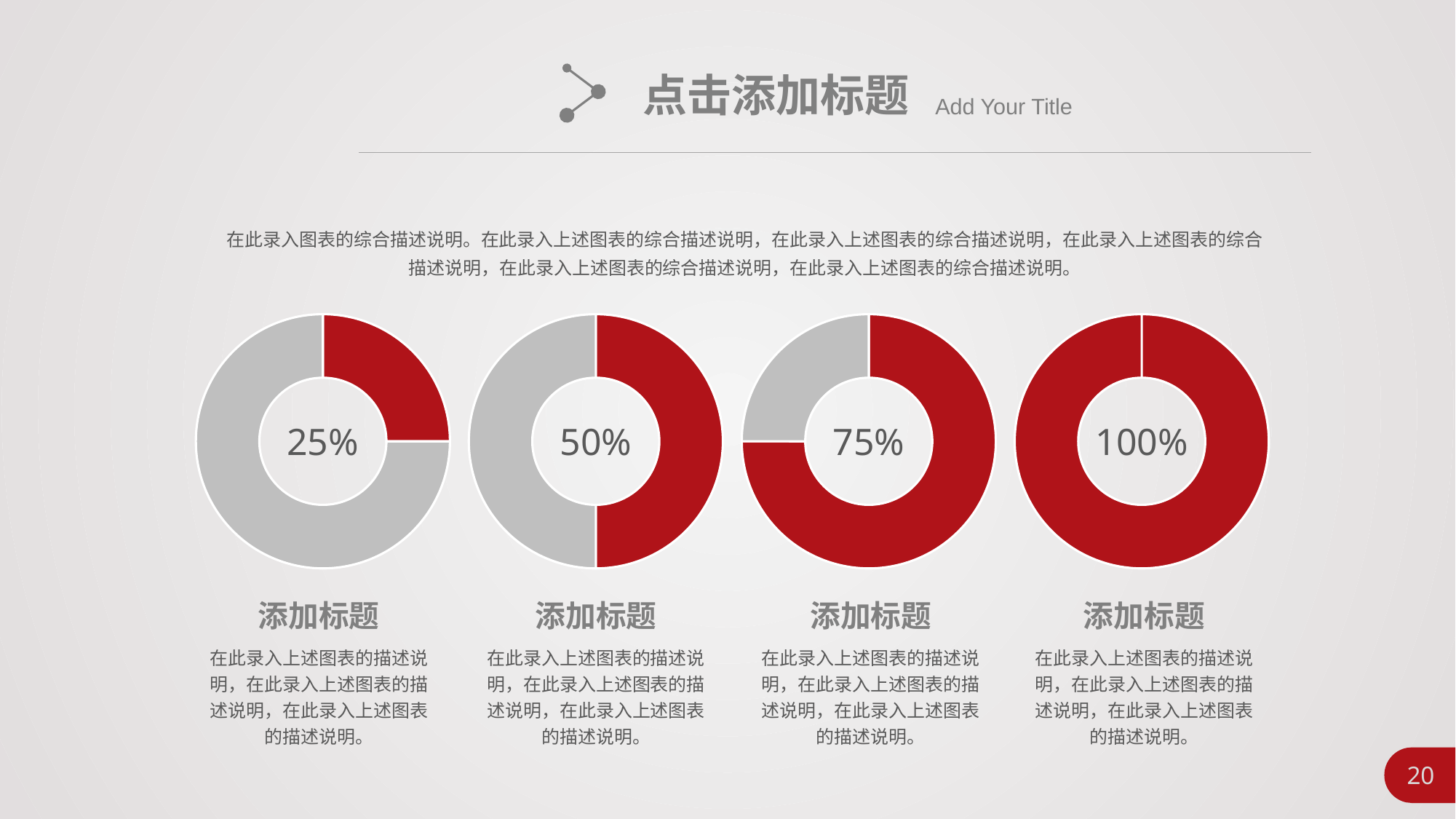
What colour is used for the filled portion of each donut chart? Red How many donut charts are on the slide? 4 What percentage is shown in the leftmost donut chart? 25% Do the percentages in the donut charts increase or decrease from left to right? Increase Which is larger, the percentage in the second donut chart or the third donut chart? The third donut chart (75%) What percentage is shown in the second donut chart from the left? 50% What kind of chart is used for the four figures on the slide? Donut chart What percentage is shown in the rightmost donut chart? 100% What percentage is shown in the third donut chart from the left? 75% What is the difference between the percentage in the rightmost donut chart and the leftmost donut chart? 75% Which donut chart shows the lowest percentage? The leftmost one (25%) Which donut chart shows the highest percentage? The rightmost one (100%)